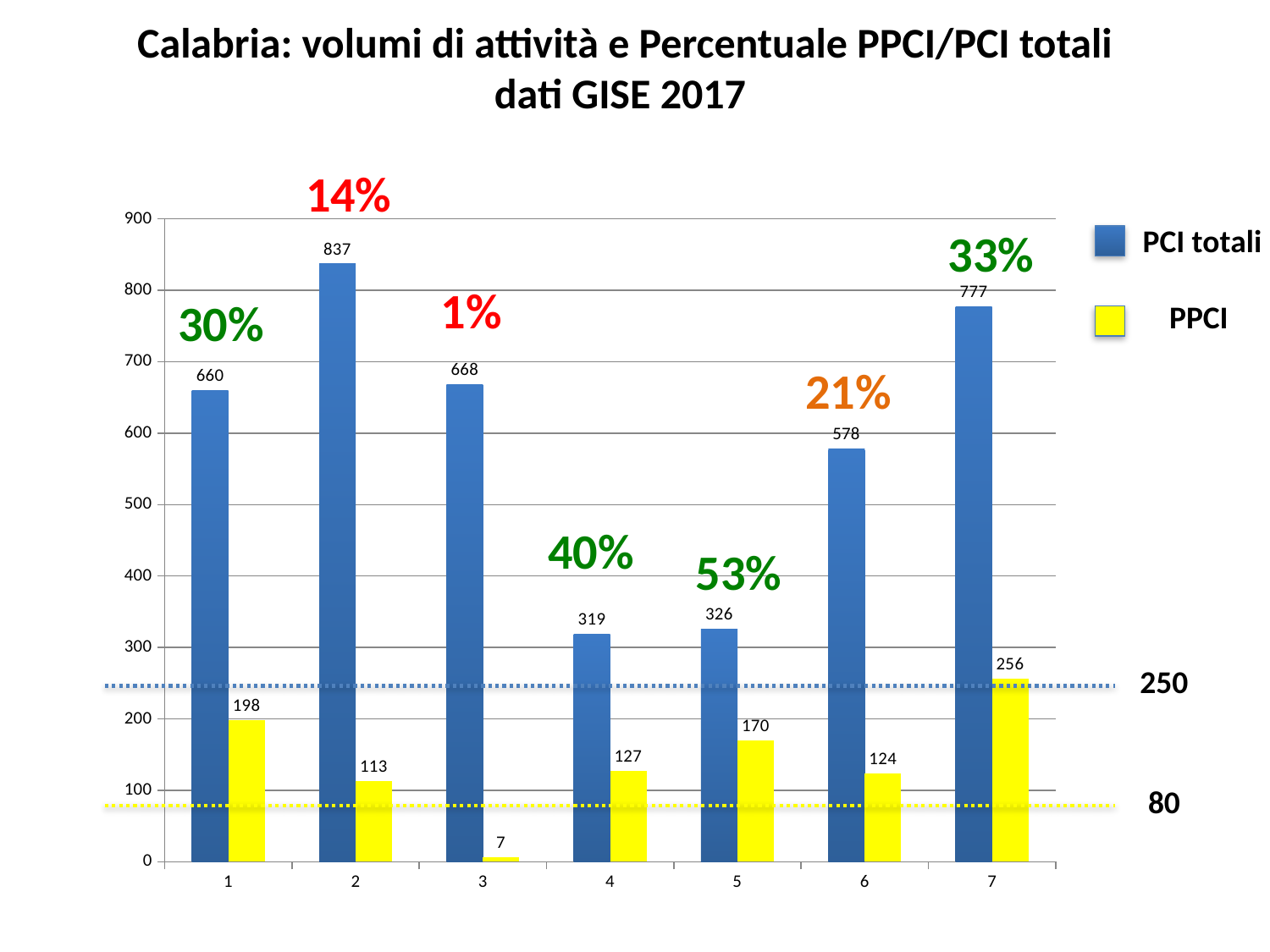
Which category has the highest PCI totali value? 2 What percentage is annotated above category 5? 53% Which is larger, the PCI totali value for category 4 or for category 5? category 5 Which category has the lowest PPCI value? 3 What is the PCI totali value for category 2? 837 What kind of chart is shown on the slide? bar chart What is the difference between PCI totali and PPCI for category 1? 462 What is the PPCI value for category 7? 256 Is the PPCI value for category 7 greater or less than 250? greater How many series does the legend list? 2 What is the PPCI value for category 3? 7 How many categories are shown on the x axis? 7